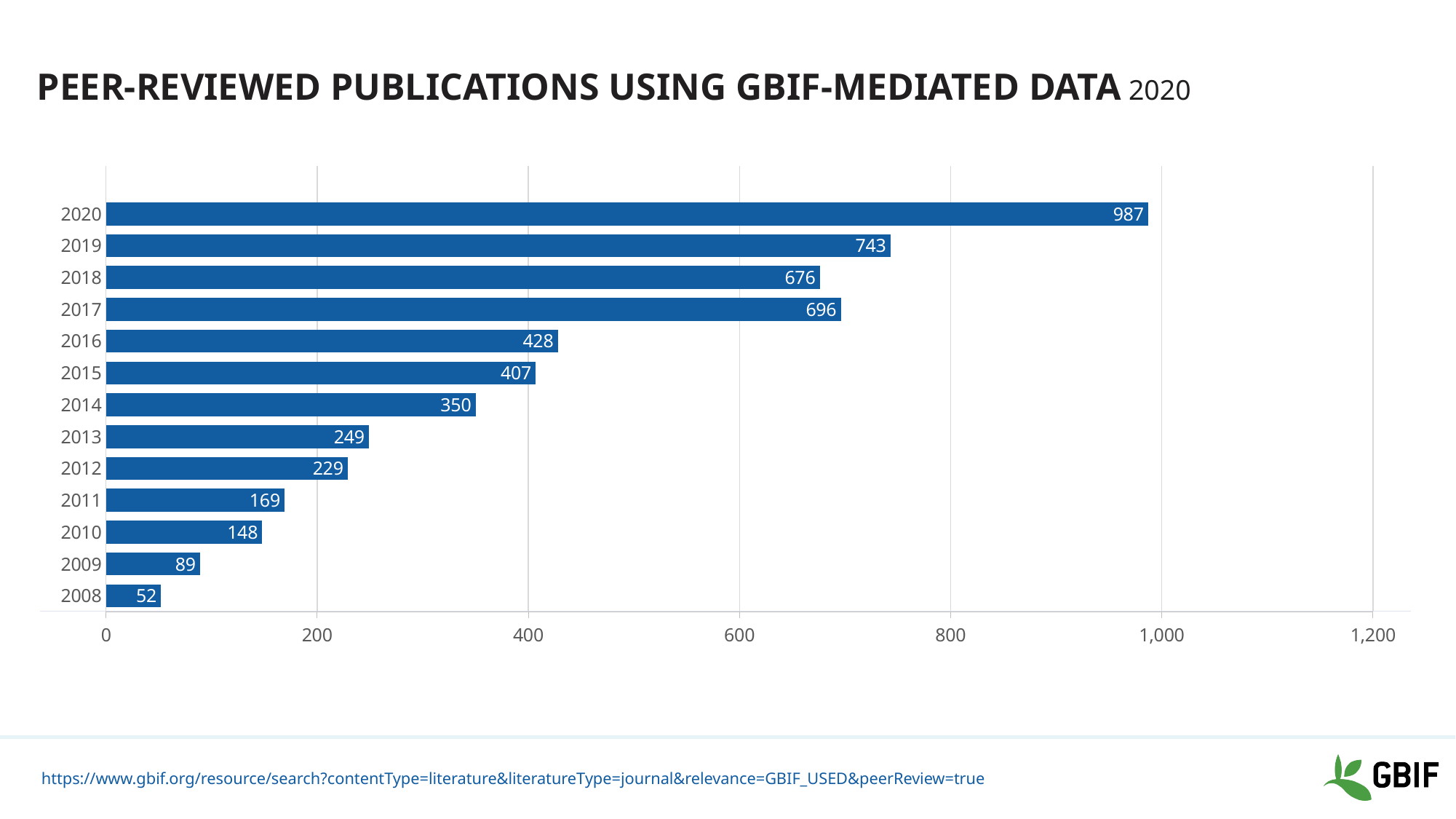
Which is larger, the value for 2017 or the value for 2018? 2017 How many peer-reviewed publications using GBIF-mediated data were there in 2020? 987 What is the difference between the values for 2020 and 2019? 244 How many years are shown on the chart? 13 What is the value shown for 2014? 350 Which is larger, the value for 2015 or the value for 2016? 2016 What kind of chart is shown on the slide? Bar chart What is the value shown for 2008? 52 What is the title of the chart? PEER-REVIEWED PUBLICATIONS USING GBIF-MEDIATED DATA 2020 Which year has the lowest number of publications? 2008 What is the difference between the values for 2017 and 2018? 20 Which year has the highest number of publications? 2020